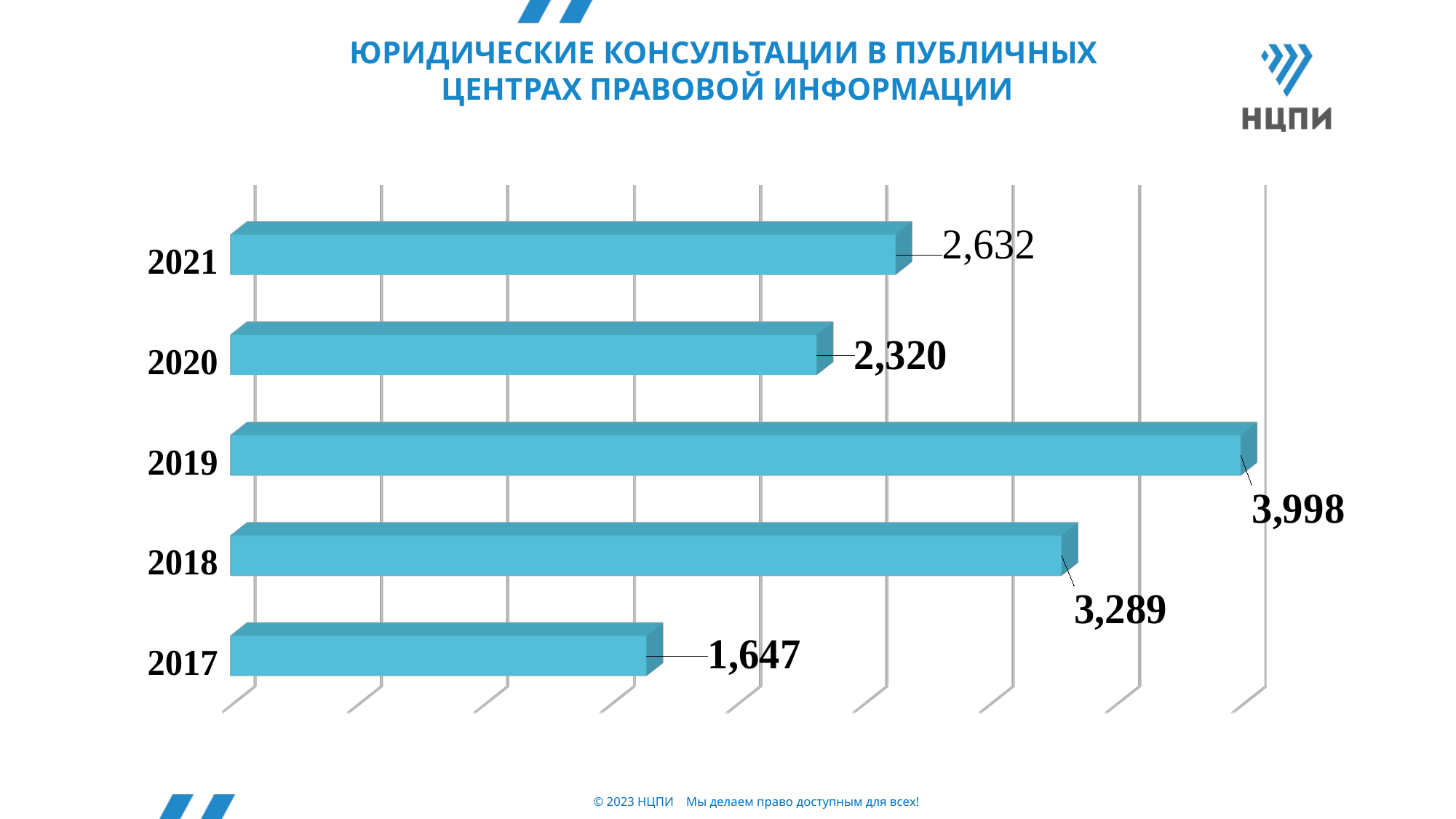
What kind of chart is shown on the slide? Bar chart What is the value for 2017? 1,647 What is the difference between the values for 2019 and 2018? 709 What is the value for 2020? 2,320 Do the values rise or fall from 2017 to 2019? Rise What is the value for 2021? 2,632 How many years are shown in the chart? 5 What is the difference between the values for 2021 and 2020? 312 What is the value for 2019? 3,998 Which year has the highest value? 2019 Which year has the lowest value? 2017 Which is larger, the value for 2018 or the value for 2021? 2018